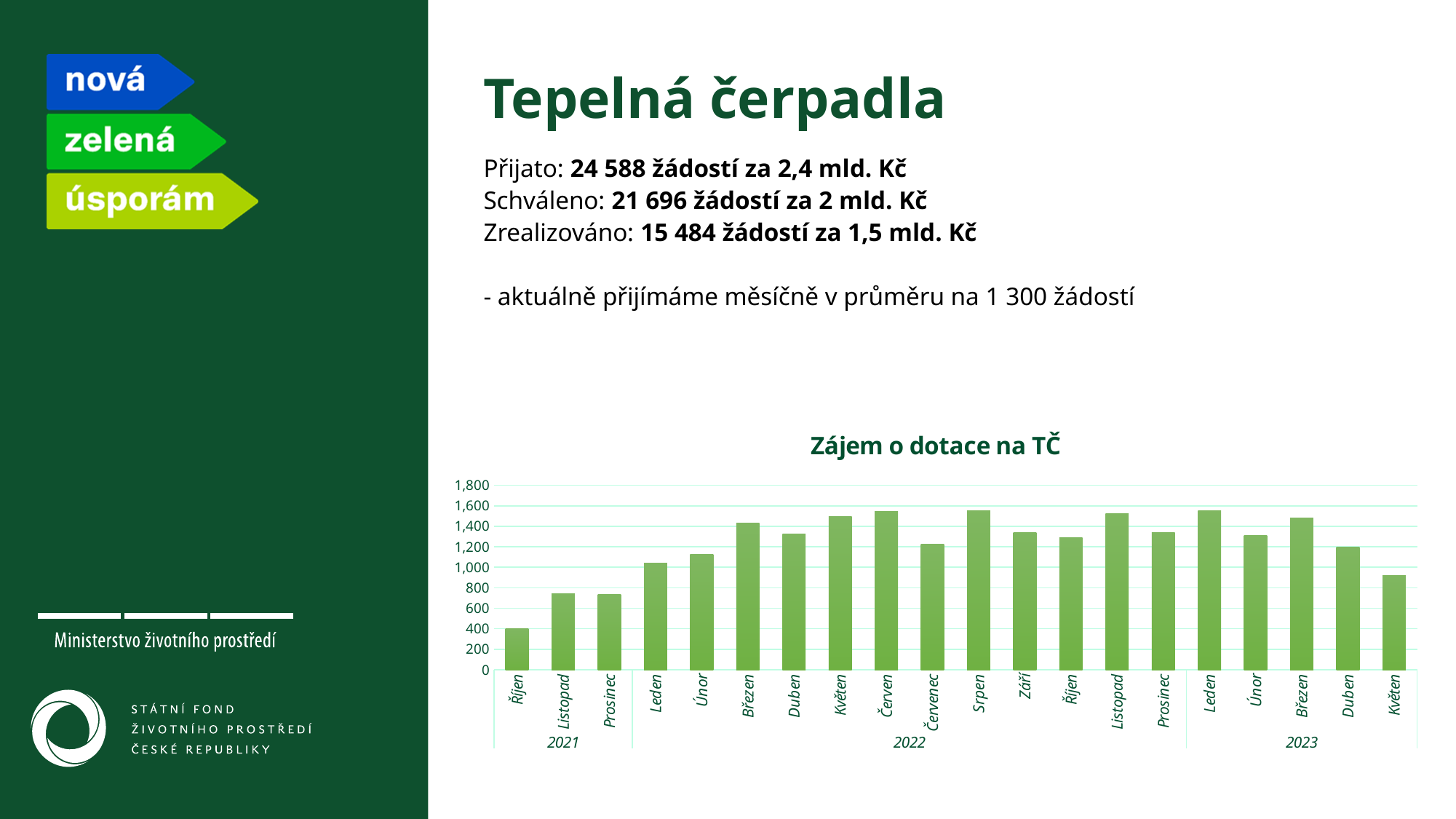
Is the value for Květen 2023 greater or less than 1,000? less Which month has the lowest bar in the chart? Říjen 2021 What kind of chart is shown under the title 'Zájem o dotace na TČ'? bar chart Which is larger, the value for Duben 2023 or for Květen 2023? Duben 2023 Is the value for Leden 2022 greater or less than 1,000? greater Do the values rise or fall from Říjen 2021 to Březen 2022? rise Is the value for Listopad 2021 greater or less than 800? less How many bars (months) are plotted in the chart? 20 Which is larger, the value for Březen 2022 or for Duben 2022? Březen 2022 What is the title of the chart on the slide? Zájem o dotace na TČ